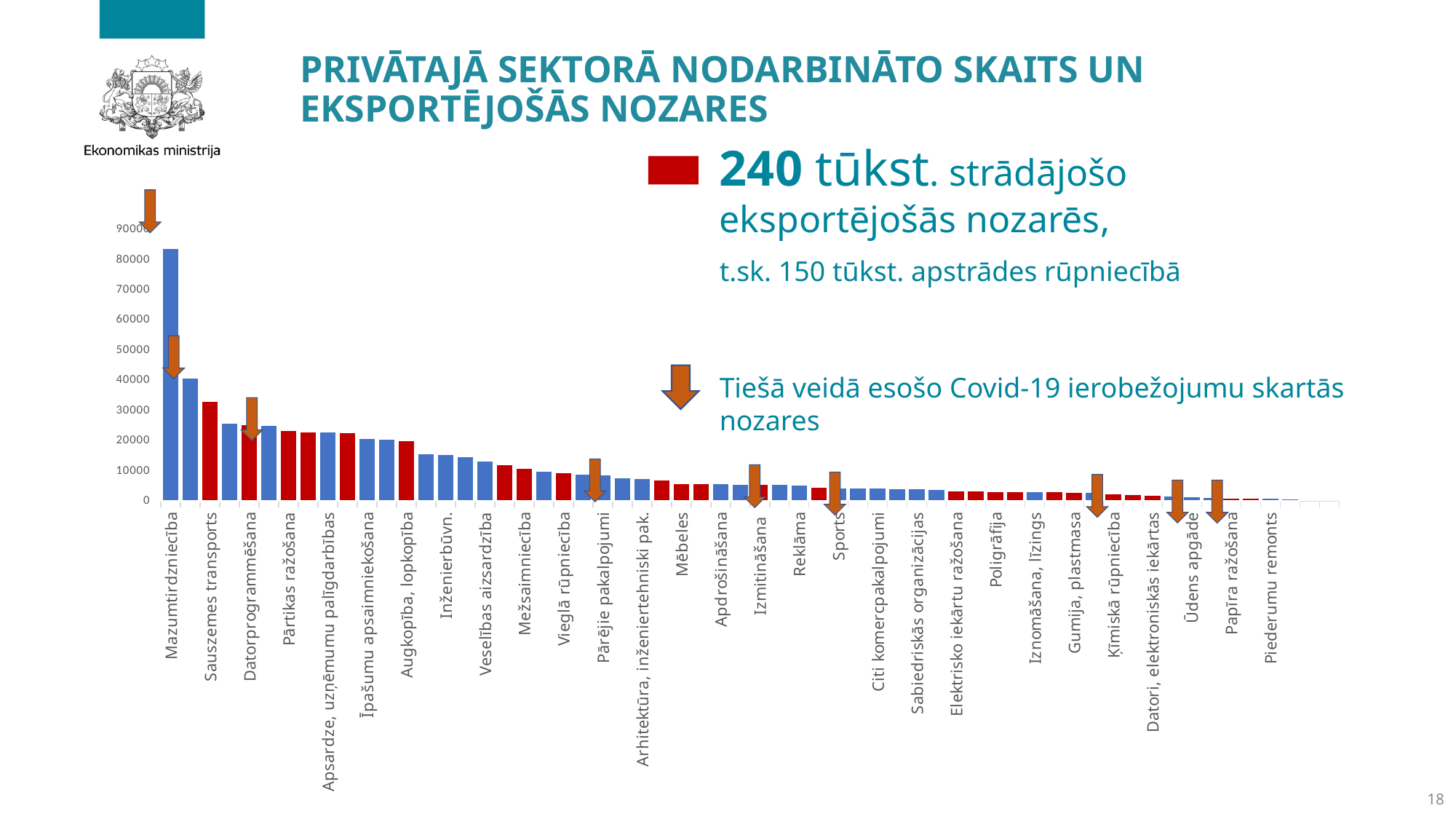
Which is larger, the value for Pārtikas ražošana or the value for Mēbeles? Pārtikas ražošana Is the value for Datorprogrammēšana greater or less than 20000? greater Is the value for Mazumtirdzniecība greater or less than 80000? greater According to the slide, what do the red bars in the chart represent? eksportējošās nozares (exporting sectors) Which category has the highest value in the chart? Mazumtirdzniecība Do the bar values generally rise or fall from left to right along the x axis? fall Which is larger, the value for Sauszemes transports or the value for Datorprogrammēšana? Sauszemes transports Is the value for Sauszemes transports greater or less than 20000? greater Which is larger, the value for Mazumtirdzniecība or the value for Sauszemes transports? Mazumtirdzniecība What kind of chart is shown on the slide? bar chart